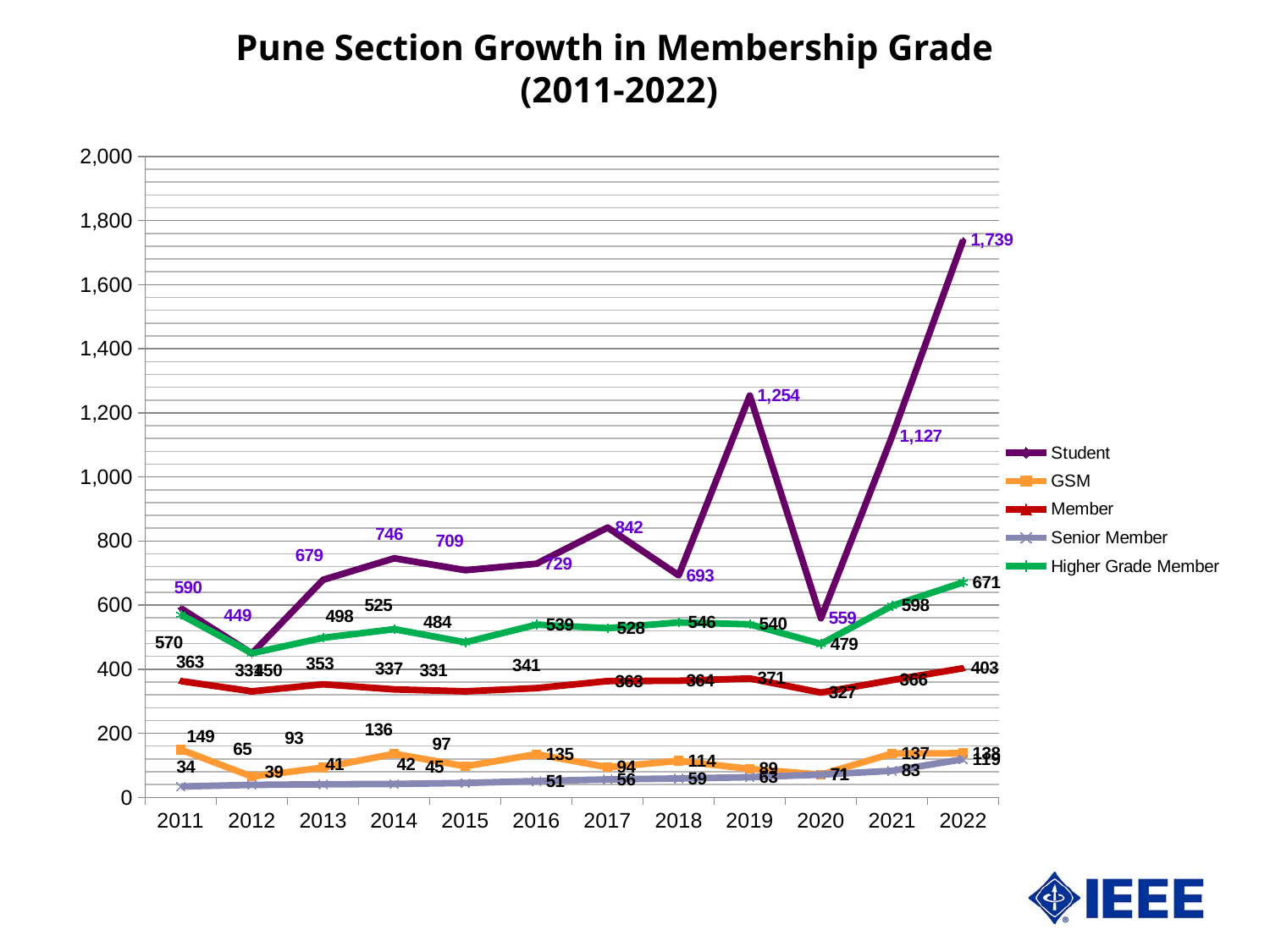
By how much did the Student value increase from 2021 to 2022? 612 What is the Higher Grade Member value in 2022? 671 What is the Student value in 2019? 1,254 What is the Student value in 2022? 1,739 How many years are plotted on the x axis? 12 What is the Senior Member value in 2011? 34 In which year is the Student series at its highest? 2022 How many series does the legend list? 5 In 2020, which is larger: the Student value or the Higher Grade Member value? Student In which year is the Student series at its lowest? 2012 What kind of chart is shown on the slide? Line chart What is the Member value in 2022? 403